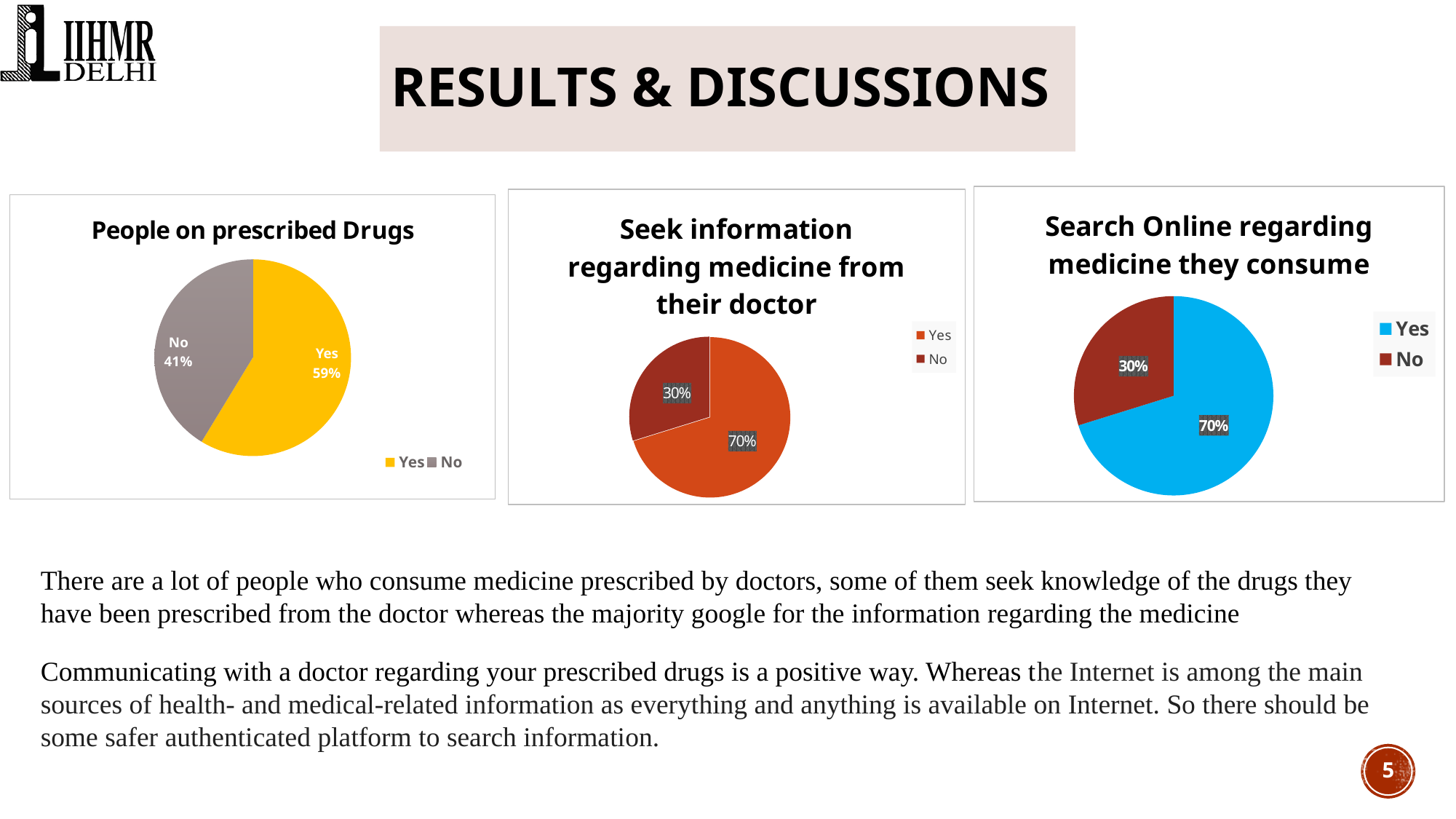
How many entries does the legend of the 'People on prescribed Drugs' chart list? 2 What type of chart is the 'Search Online regarding medicine they consume' chart? Pie chart In the 'Seek information regarding medicine from their doctor' chart, what percentage is shown for No? 30% How many slices does the 'Seek information regarding medicine from their doctor' pie chart have? 2 In the 'Search Online regarding medicine they consume' chart, which category has the smaller share? No In the 'Seek information regarding medicine from their doctor' chart, what percentage is shown for Yes? 70% In the 'People on prescribed Drugs' chart, which category has the larger share? Yes In the 'Search Online regarding medicine they consume' chart, what colour is the Yes slice? Blue In the 'People on prescribed Drugs' chart, what percentage answered Yes? 59% In the 'People on prescribed Drugs' chart, what percentage answered No? 41% In the 'Search Online regarding medicine they consume' chart, what percentage answered Yes? 70% In the 'People on prescribed Drugs' chart, what is the difference between the Yes and No shares? 18%